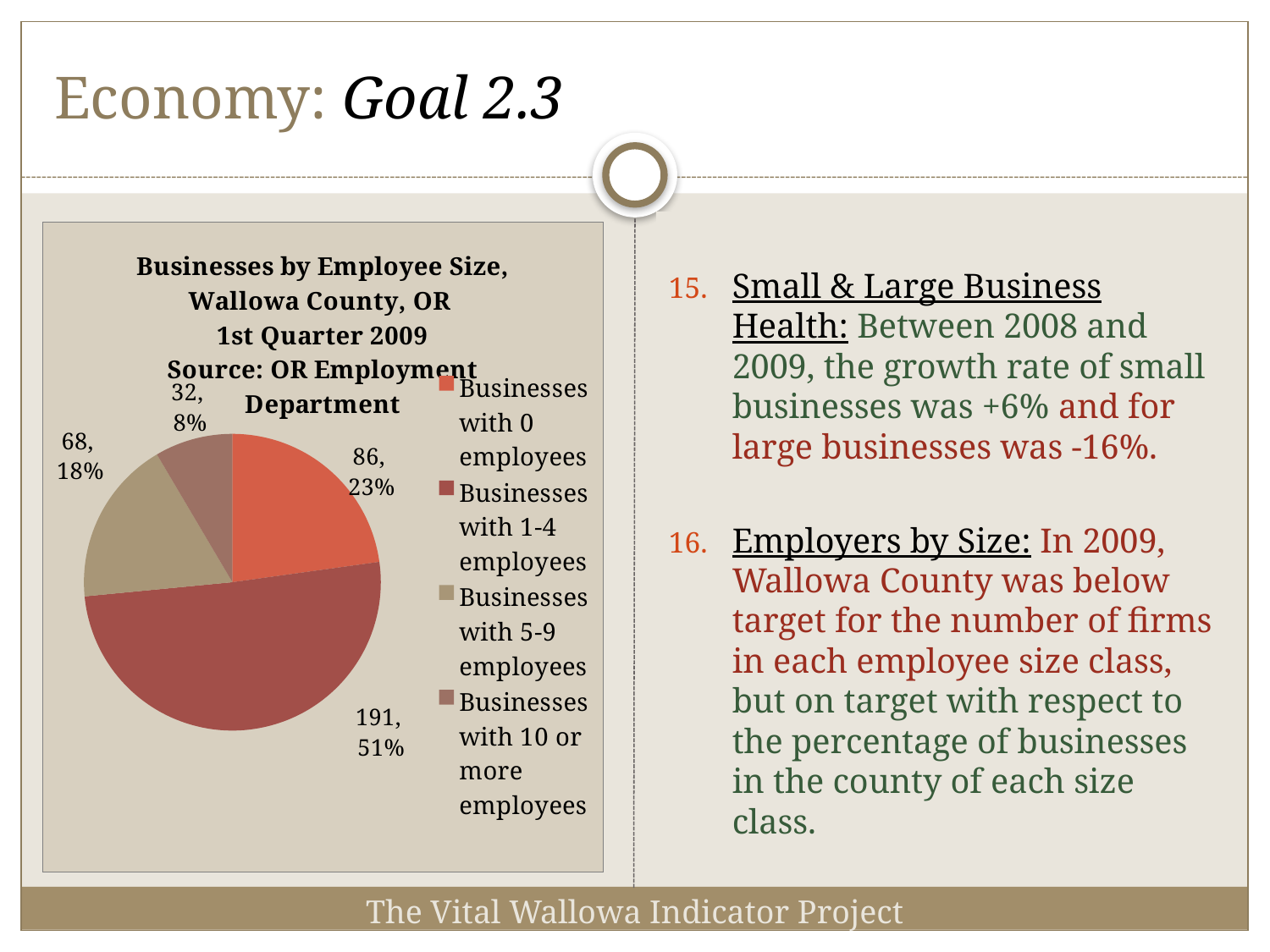
How many employee size classes does the pie chart show? 4 How many businesses with 10 or more employees are shown in the pie chart? 32 What share of the pie is taken by businesses with 5-9 employees? 18% What is the total number of businesses represented in the pie chart? 377 Which is larger: the number of businesses with 5-9 employees or the number with 10 or more employees? Businesses with 5-9 employees Which employee size class has the smallest slice of the pie? Businesses with 10 or more employees According to the chart title, what is the source of the data? OR Employment Department How many businesses with 1-4 employees are shown in the pie chart? 191 Which employee size class has the largest slice of the pie? Businesses with 1-4 employees What is the difference between the number of businesses with 1-4 employees and the number with 0 employees? 105 What type of chart is shown on the slide? Pie chart What percentage of businesses have 0 employees according to the pie chart? 23%